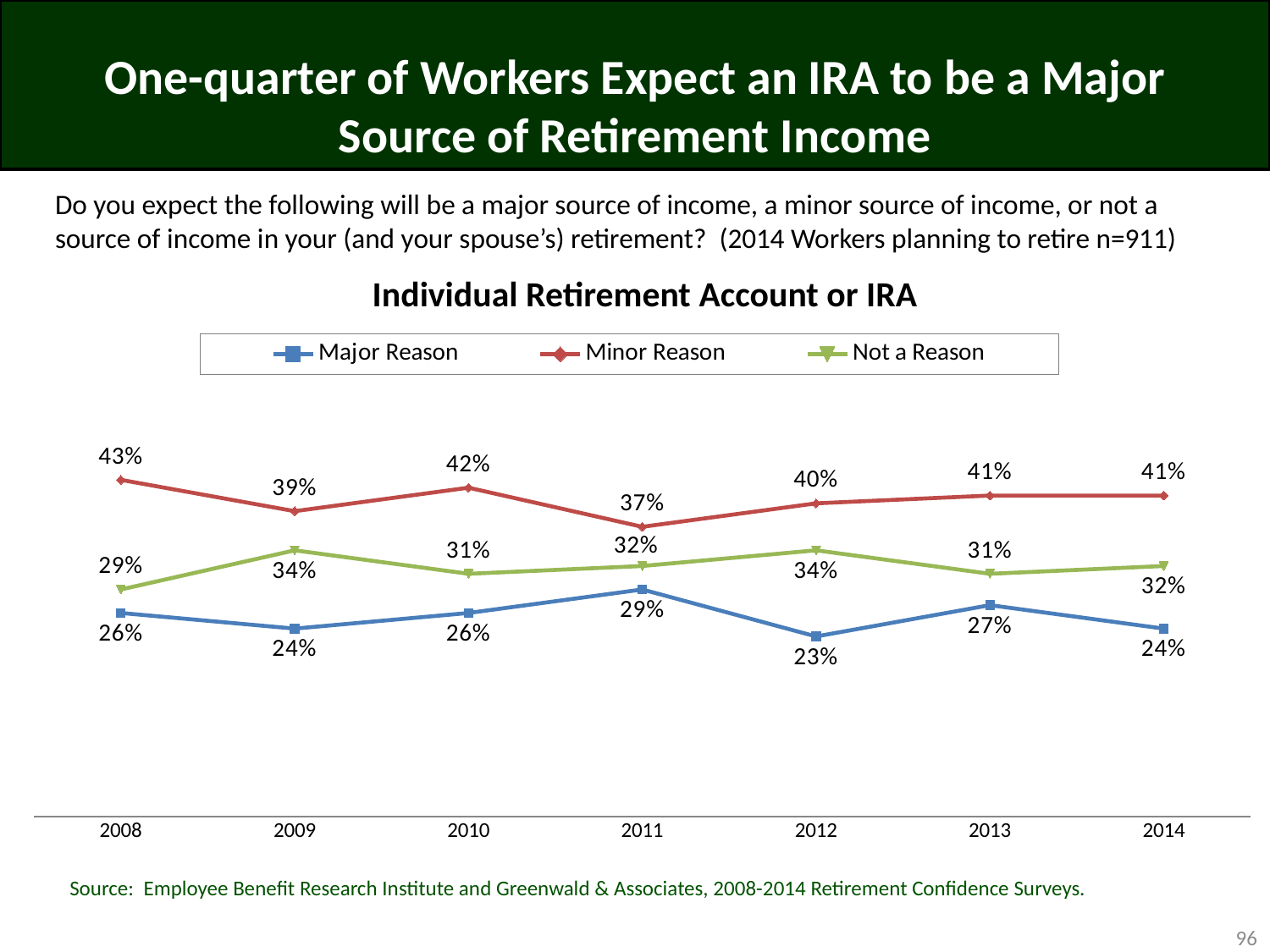
What is the title of the chart? Individual Retirement Account or IRA In which year is the Major Reason value highest? 2011 Does the Major Reason value rise or fall from 2011 to 2012? fall In which year is the Minor Reason value lowest? 2011 What is the difference between the Minor Reason and Major Reason values in 2014? 17% How many years are shown on the x axis? 7 What is the value for Major Reason in 2012? 23% Which is larger in 2013: Not a Reason or Major Reason? Not a Reason How many series does the legend list? 3 What type of chart is shown on the slide? line chart What is the value for Not a Reason in 2009? 34% What is the value for Minor Reason in 2008? 43%